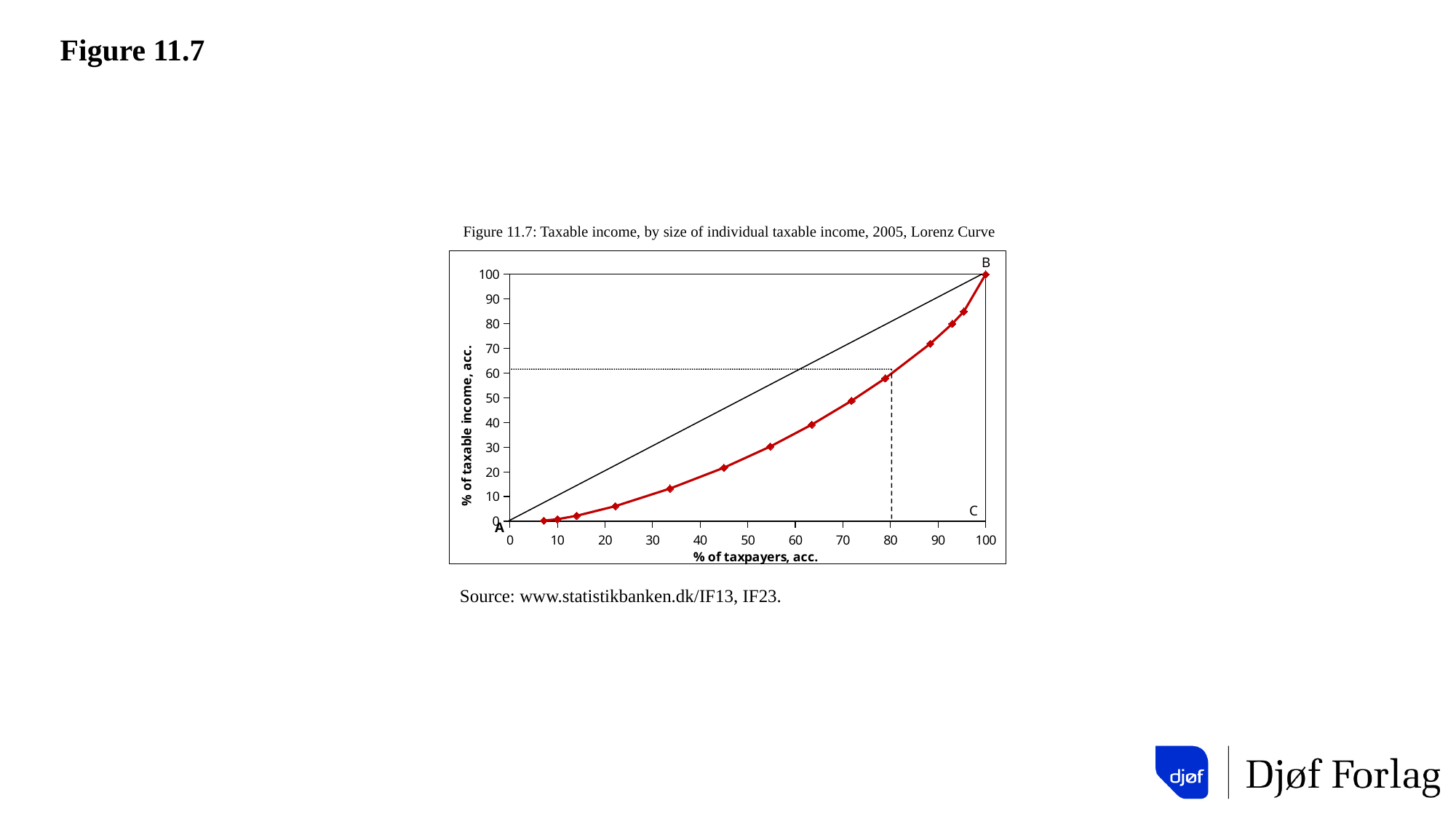
At 50% of taxpayers, which is higher: the red Lorenz curve or the straight diagonal line from A to B? The straight diagonal line What is the label of the x axis? % of taxpayers, acc. Does the red Lorenz curve rise or fall as the % of taxpayers increases? Rises Is the value of the red curve at 60% of taxpayers greater or less than 40? less What kind of chart is shown on the slide? Line chart What is the title of the chart? Figure 11.7: Taxable income, by size of individual taxable income, 2005, Lorenz Curve What is the highest value reached by the red curve on the y axis? 100 Is the value of the red curve at 90% of taxpayers greater or less than 70? greater Is the value of the red curve at 40% of taxpayers greater or less than 20? less What is the value of the red curve (% of taxable income, acc.) at 100% of taxpayers? 100